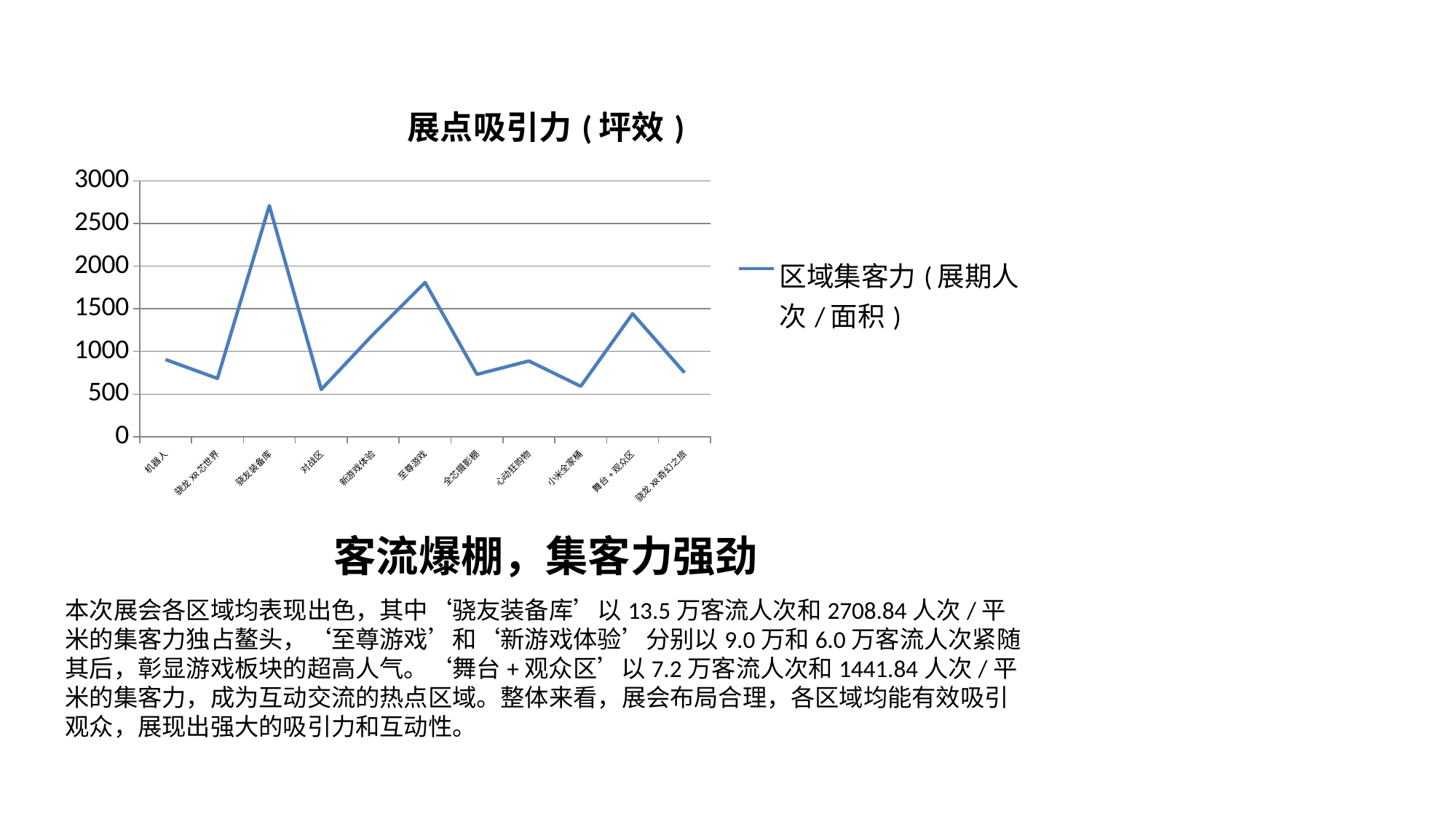
Is the value for 骁友装备库 greater or less than 2500? greater Is the value for 至尊游戏 greater or less than 1500? greater Is the value for 小米全家桶 greater or less than 1000? less What is the name of the series shown in the legend? 区域集客力（展期人次／面积） Which category has the highest value? 骁友装备库 Which has a larger value, 至尊游戏 or 舞台＋观众区? 至尊游戏 How many series does the legend list? 1 How many categories are plotted along the x axis? 11 Does the line rise or fall from 骁友装备库 to 对战区? fall What is the title of the chart? 展点吸引力（坪效） What kind of chart is shown on the slide? line chart